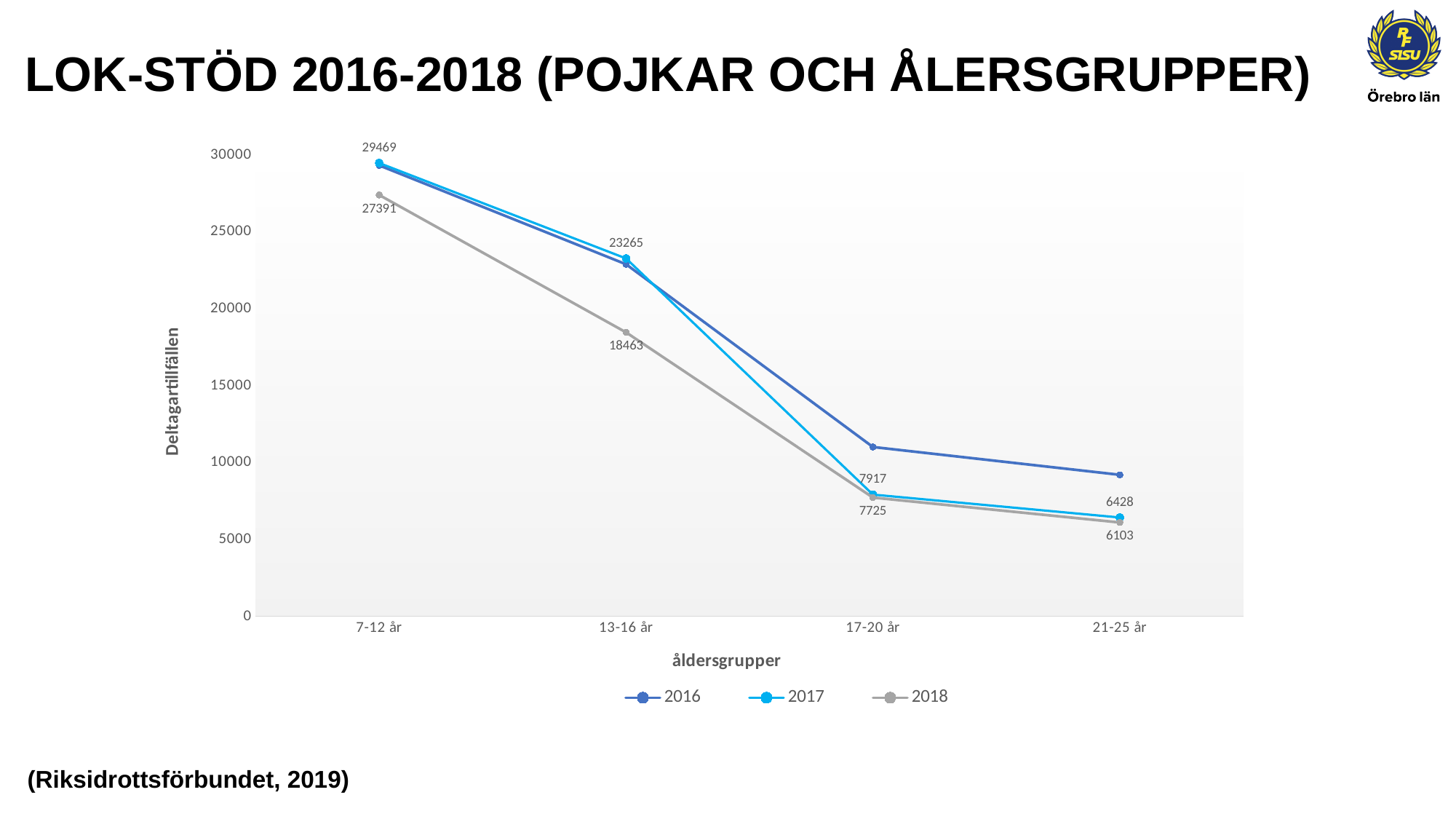
What is the value for 2017 in the 13-16 år age group? 23265 How many series does the legend list? 3 Is the value for 2016 in the 21-25 år age group greater or less than 10000? less In the 17-20 år age group, which series has the larger value, 2016 or 2017? 2016 What is the value for 2018 in the 21-25 år age group? 6103 What kind of chart is shown on the slide? line chart Do the values for the 2018 series rise or fall from 7-12 år to 21-25 år? fall What is the value for 2018 in the 7-12 år age group? 27391 What is the difference between the 2017 and 2018 values in the 21-25 år age group? 325 What is the value for 2018 in the 13-16 år age group? 18463 How many age groups are shown on the x axis? 4 What is the title of the y axis? Deltagartillfällen